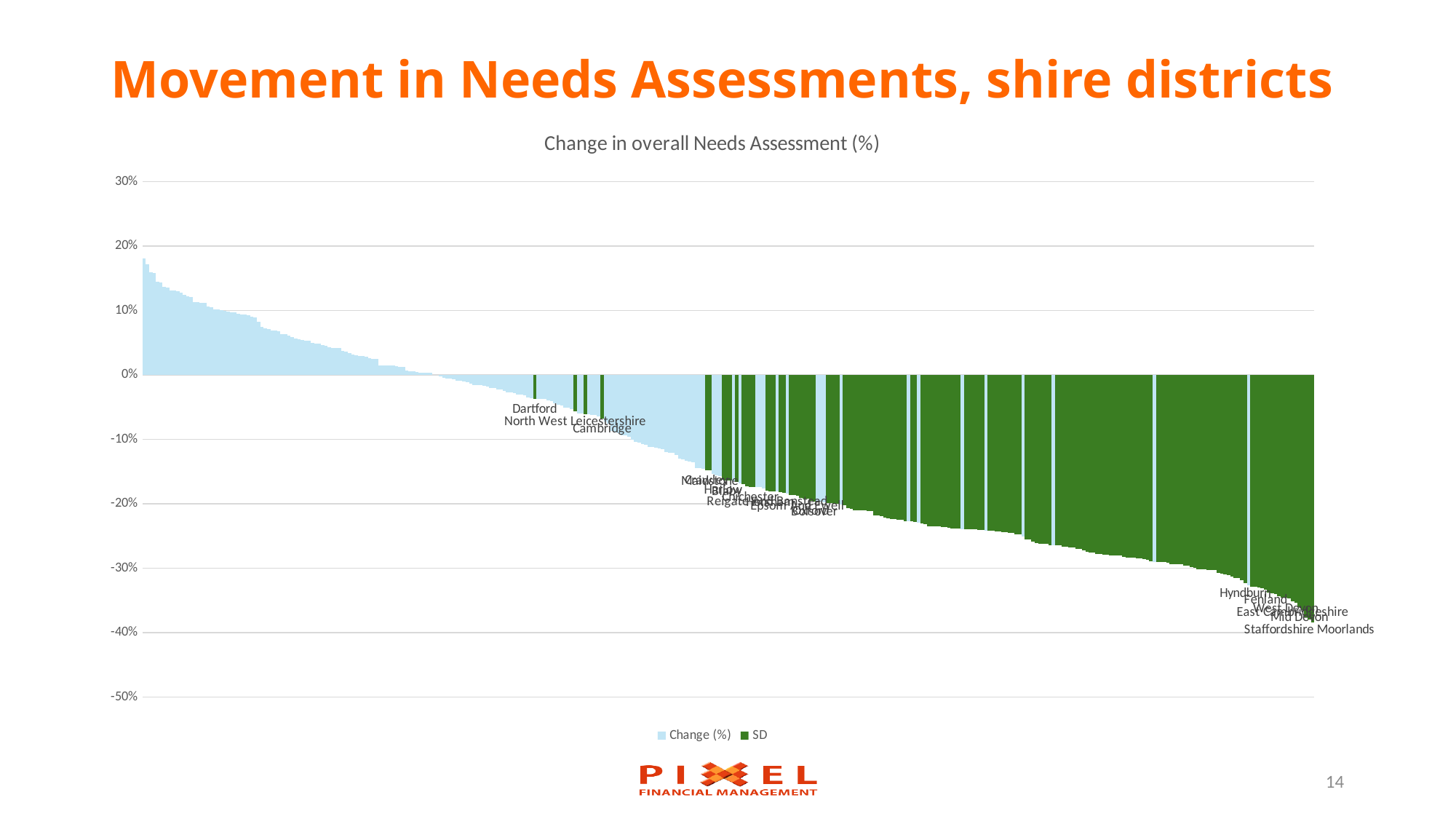
Is the value for Cambridge greater or less than 0%? less Is the largest value plotted on the chart greater or less than 20%? less How many series does the legend list? 2 Is the value for Dartford greater or less than 0%? less What is the title of the chart? Change in overall Needs Assessment (%) Do the plotted values rise or fall moving from left to right along the x axis? fall What kind of chart is shown on the slide? bar chart What are the two series named in the legend? Change (%) and SD